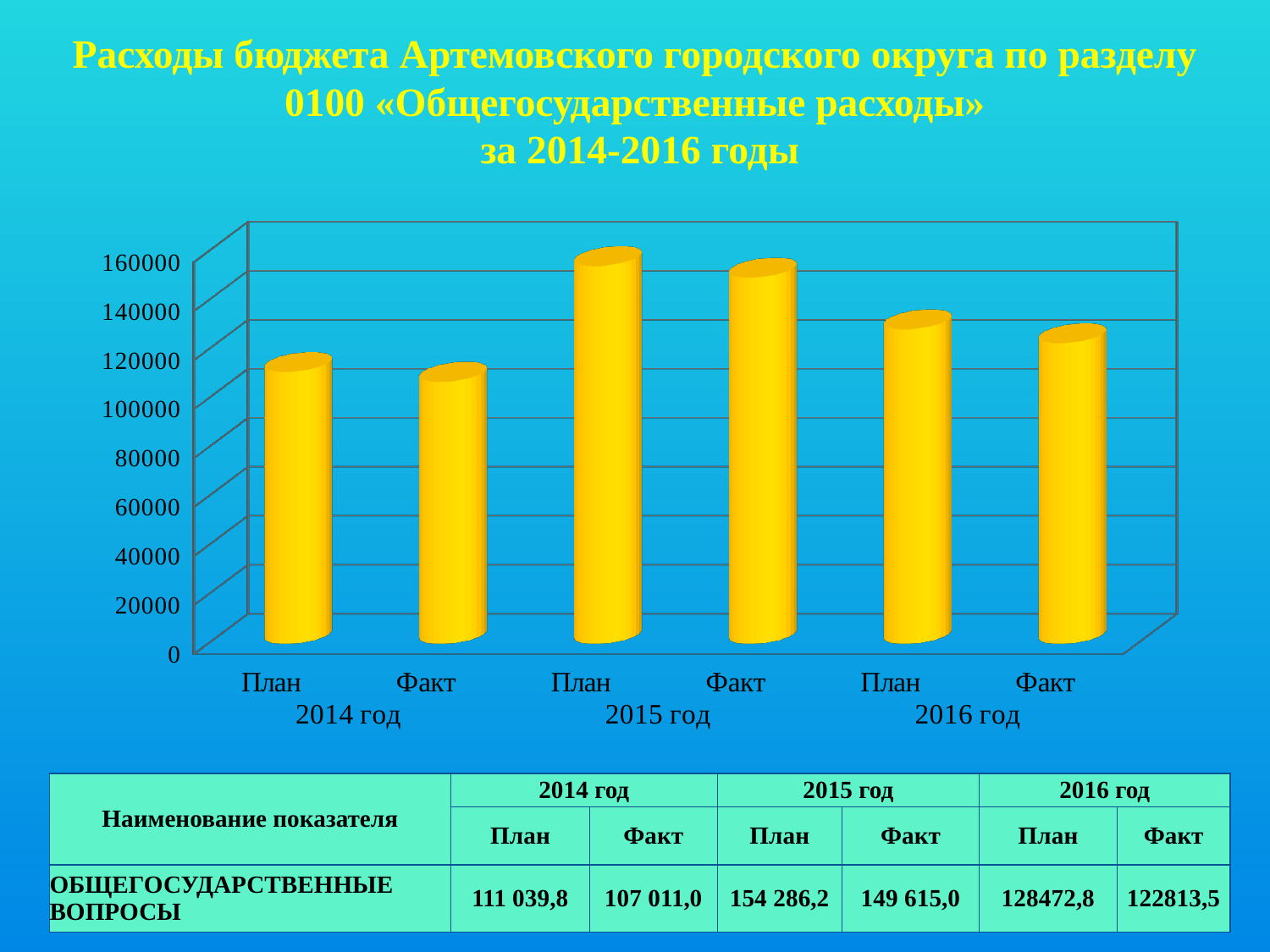
What is the value for План (plan) in 2014 год? 111 039,8 Which years are shown on the x axis of the chart? 2014 год, 2015 год, 2016 год What type of chart is shown on the slide? bar chart How many bars are plotted in the chart? 6 Which is larger, План 2016 год or Факт 2016 год? План 2016 год What is the difference between План and Факт for 2014 год? 4 028,8 What is the value for Факт (actual) in 2016 год? 122813,5 Which bar is the highest in the chart? План 2015 год Is the value for Факт 2014 год greater or less than 120000? less Is the value for План 2015 год greater or less than 140000? greater Which bar is the lowest in the chart? Факт 2014 год What is the value for Факт (actual) in 2015 год? 149 615,0